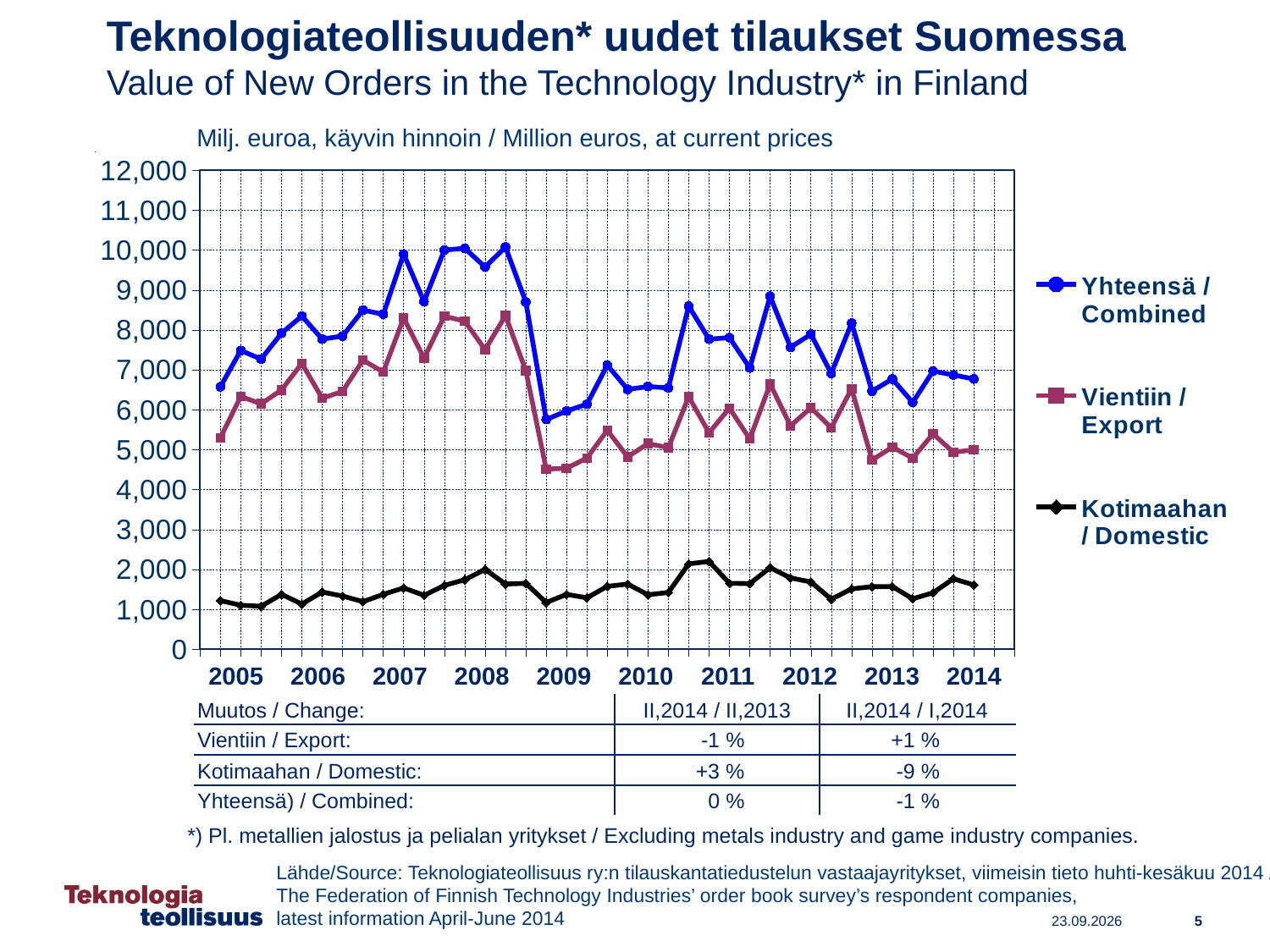
Does the Yhteensä / Combined series rise or fall between 2008 and 2009? fall How many series does the legend list? 3 Is the value for Vientiin / Export in 2014 greater or less than 6,000? less How many years are labelled on the x axis? 10 Which series has the lowest values throughout the chart? Kotimaahan / Domestic What kind of chart is shown on the slide? line chart Is the value for Yhteensä / Combined at the start of 2009 greater or less than 7,000? less What is the highest value shown on the y axis? 12,000 Which series has the highest values throughout the chart? Yhteensä / Combined Is the value for Kotimaahan / Domestic in 2010 greater or less than 3,000? less Which is larger in 2012, the value for Vientiin / Export or for Kotimaahan / Domestic? Vientiin / Export